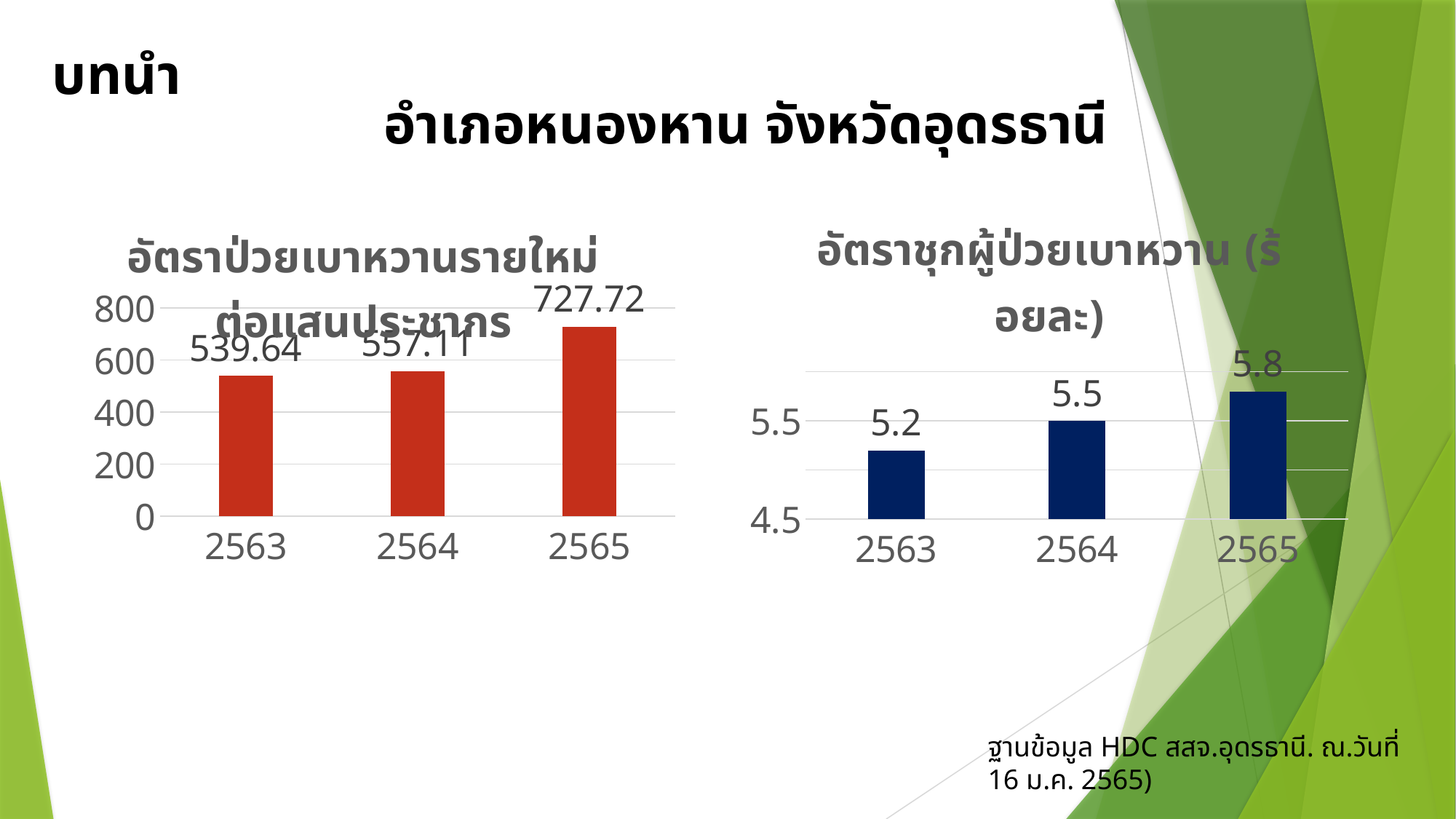
In the left chart (อัตราป่วยเบาหวานรายใหม่ต่อแสนประชากร), what is the difference between the values for 2565 and 2564? 170.61 In the left chart (อัตราป่วยเบาหวานรายใหม่ต่อแสนประชากร), which year has the lowest value? 2563 In the left chart (อัตราป่วยเบาหวานรายใหม่ต่อแสนประชากร), do the values rise or fall from 2563 to 2565? rise In the left chart (อัตราป่วยเบาหวานรายใหม่ต่อแสนประชากร), which year has the highest value? 2565 What kind of chart is the left chart (อัตราป่วยเบาหวานรายใหม่ต่อแสนประชากร)? bar chart In the left chart (อัตราป่วยเบาหวานรายใหม่ต่อแสนประชากร), what is the value for 2565? 727.72 In the right chart (อัตราชุกผู้ป่วยเบาหวาน (ร้อยละ)), what is the value for 2565? 5.8 How many years are shown on the x axis of the right chart (อัตราชุกผู้ป่วยเบาหวาน (ร้อยละ))? 3 In the right chart (อัตราชุกผู้ป่วยเบาหวาน (ร้อยละ)), which is larger, the value for 2563 or 2564? 2564 In the right chart (อัตราชุกผู้ป่วยเบาหวาน (ร้อยละ)), what is the difference between the values for 2565 and 2563? 0.6 In the right chart (อัตราชุกผู้ป่วยเบาหวาน (ร้อยละ)), what is the value for 2564? 5.5 In the left chart (อัตราป่วยเบาหวานรายใหม่ต่อแสนประชากร), what is the value for 2563? 539.64